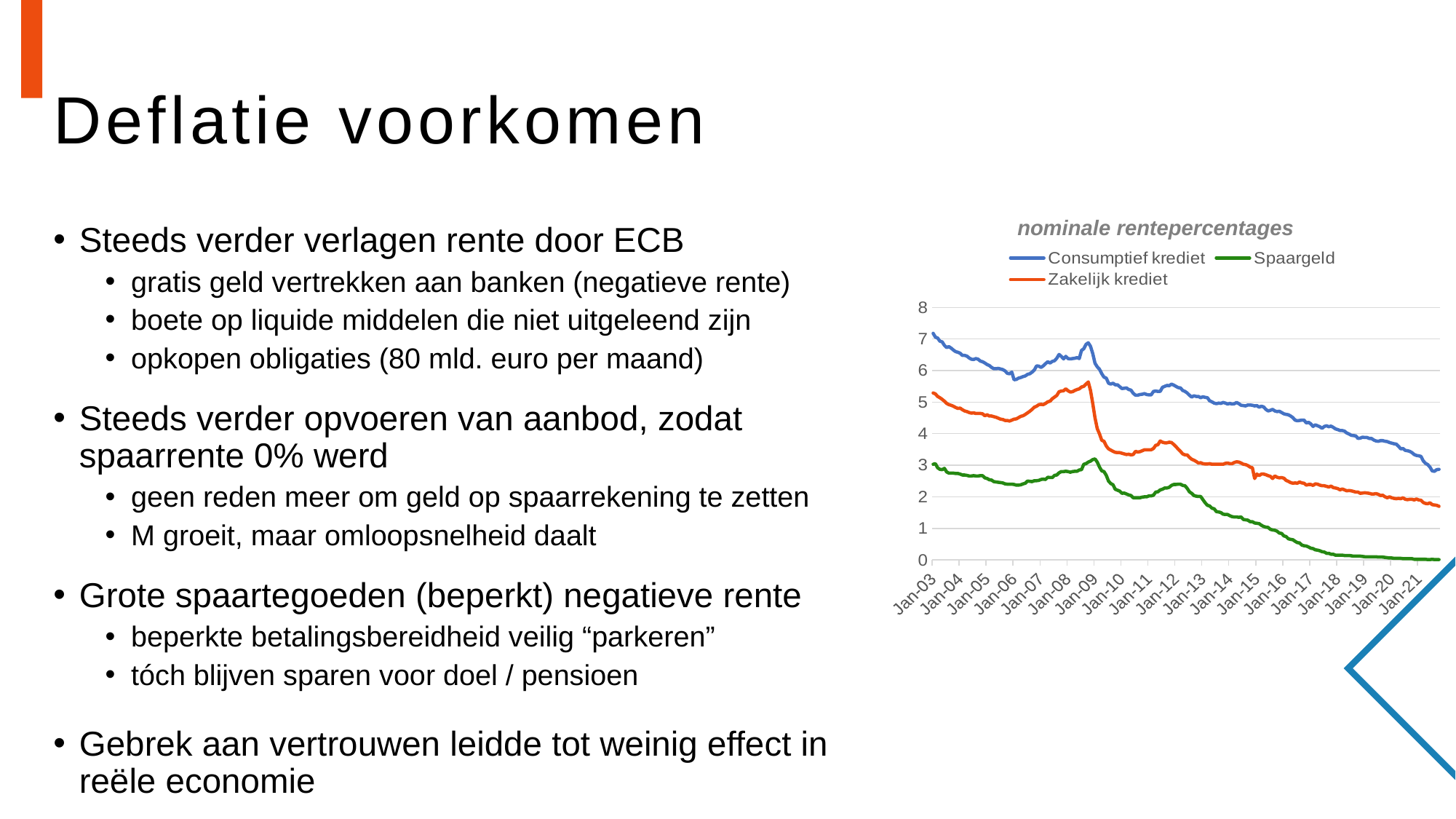
Which series in the chart is drawn in green? Spaargeld What kind of chart is shown on the slide? line chart Is the value for Consumptief krediet at Jan-03 greater or less than 6? greater Is the value for Zakelijk krediet at Jan-03 greater or less than 4? greater Does the Spaargeld series rise or fall overall from Jan-03 to Jan-21? fall At Jan-21, which is larger: Zakelijk krediet or Spaargeld? Zakelijk krediet Which series has the highest values throughout the chart? Consumptief krediet How many series does the legend of the chart list? 3 Which series has the lowest values throughout the chart? Spaargeld Is the value for Spaargeld at Jan-21 greater or less than 1? less Does the Consumptief krediet series rise or fall overall from Jan-03 to Jan-21? fall What is the title of the chart? nominale rentepercentages